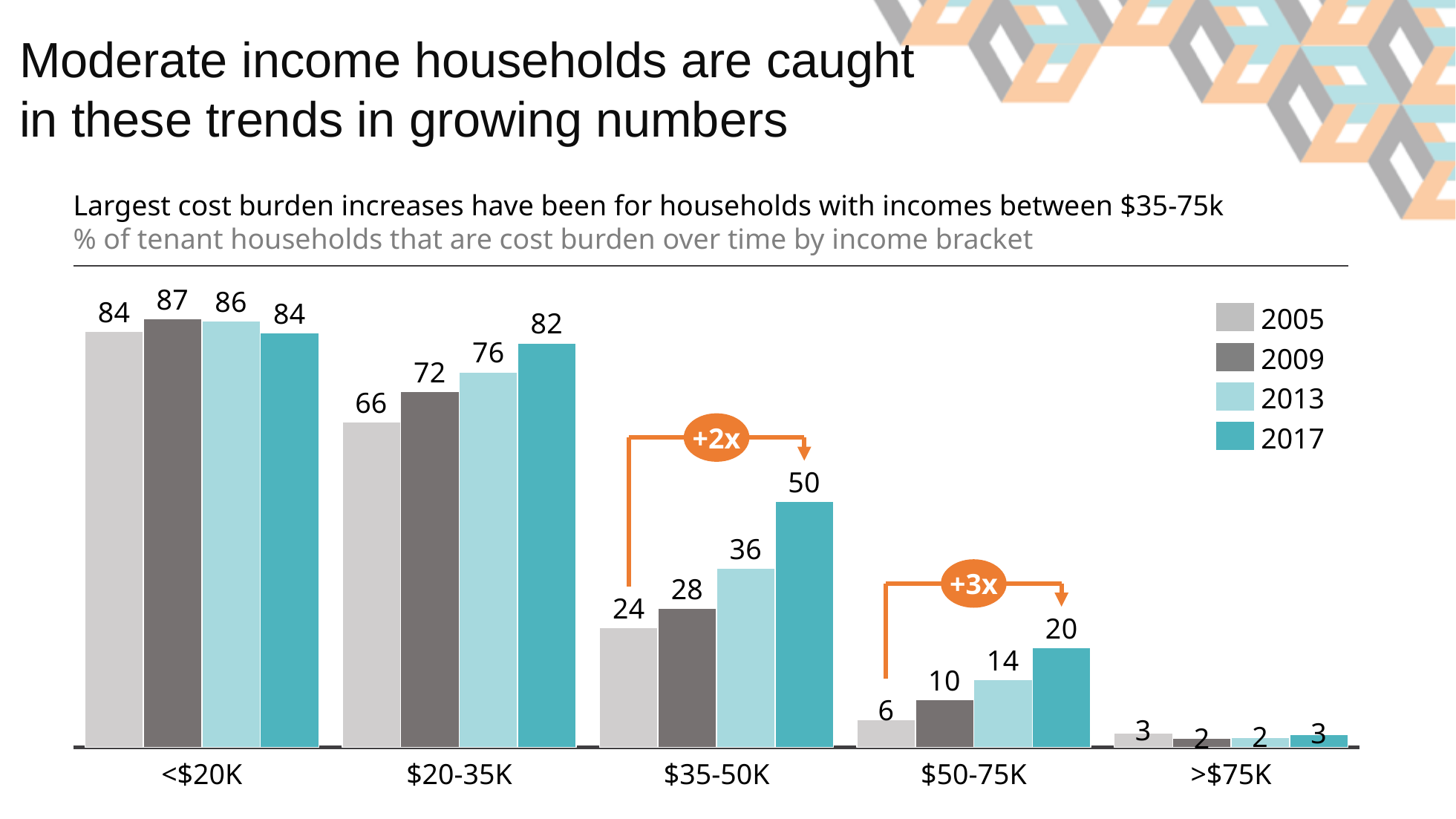
How many series does the legend list? 4 Do the values for the $50-75K income bracket rise or fall from 2005 to 2017? Rise What is the value for the $50-75K income bracket in 2005? 6 What kind of chart is shown on the slide? Bar chart Which income bracket has the highest value in 2017? <$20K Which is larger: the 2013 value for $20-35K or the 2013 value for $35-50K? $20-35K What is the difference between the 2017 and 2005 values for the $35-50K income bracket? 26 How many income brackets are shown on the x axis? 5 Which year does the darkest teal bar represent according to the legend? 2017 Which income bracket has the lowest value in 2013? >$75K What is the value for the <$20K income bracket in 2009? 87 What is the value for the $35-50K income bracket in 2017? 50